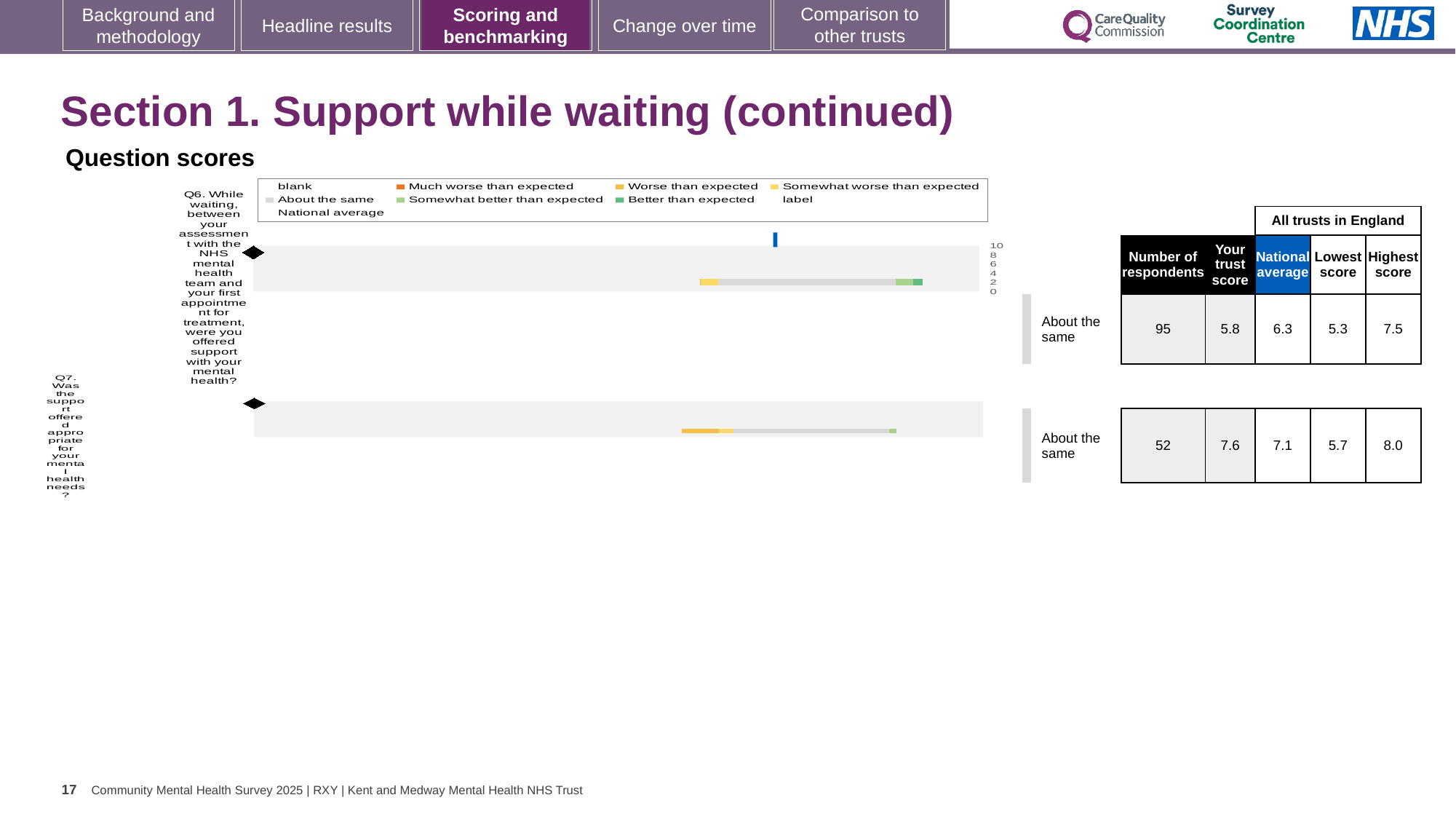
How many questions (categories) are plotted in the question scores chart? 2 What is the difference between the highest and lowest scores across all trusts in England for Q7? 2.3 What kind of chart is used to show the question scores on this slide? bar chart What is the difference between the trust score and the national average for Q6? 0.5 What is the national average score for Q6? 6.3 What is the maximum value shown on the score axis of the question scores chart? 10 Which question has the higher trust score, Q6 or Q7? Q7 What is the highest score among all trusts in England for Q7? 8.0 How many entries does the legend of the question scores chart list? 9 How many respondents answered Q7? 52 What is the trust score for Q6 (support with mental health while waiting)? 5.8 What is the trust score for Q7 (was the support offered appropriate)? 7.6